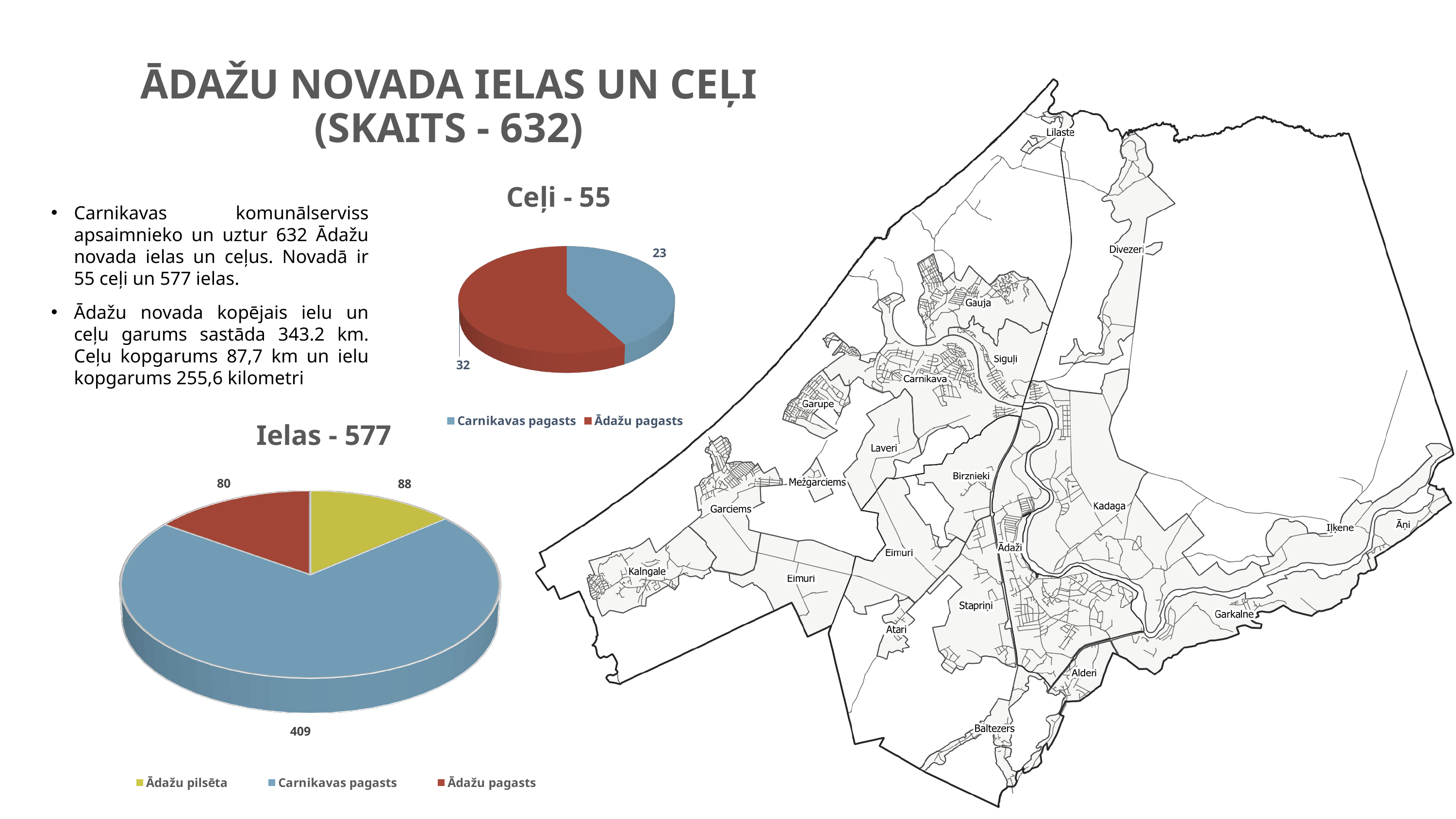
What type of chart is the 'Ceļi - 55' chart? Pie chart How many slices does the 'Ielas - 577' chart have? 3 In the 'Ielas - 577' chart, what is the difference between Ādažu pilsēta and Ādažu pagasts? 8 In the 'Ceļi - 55' chart, what is the value for Ādažu pagasts? 32 In the 'Ceļi - 55' chart, what is the value for Carnikavas pagasts? 23 How many entries does the legend of the 'Ceļi - 55' chart list? 2 In the 'Ceļi - 55' chart, what is the difference between Ādažu pagasts and Carnikavas pagasts? 9 In the 'Ceļi - 55' chart, which is larger, Carnikavas pagasts or Ādažu pagasts? Ādažu pagasts In the 'Ielas - 577' chart, which category has the largest slice? Carnikavas pagasts In the 'Ielas - 577' chart, which category has the smallest slice? Ādažu pagasts In the 'Ielas - 577' chart, what is the value for Ādažu pilsēta? 88 In the 'Ielas - 577' chart, what is the value for Carnikavas pagasts? 409